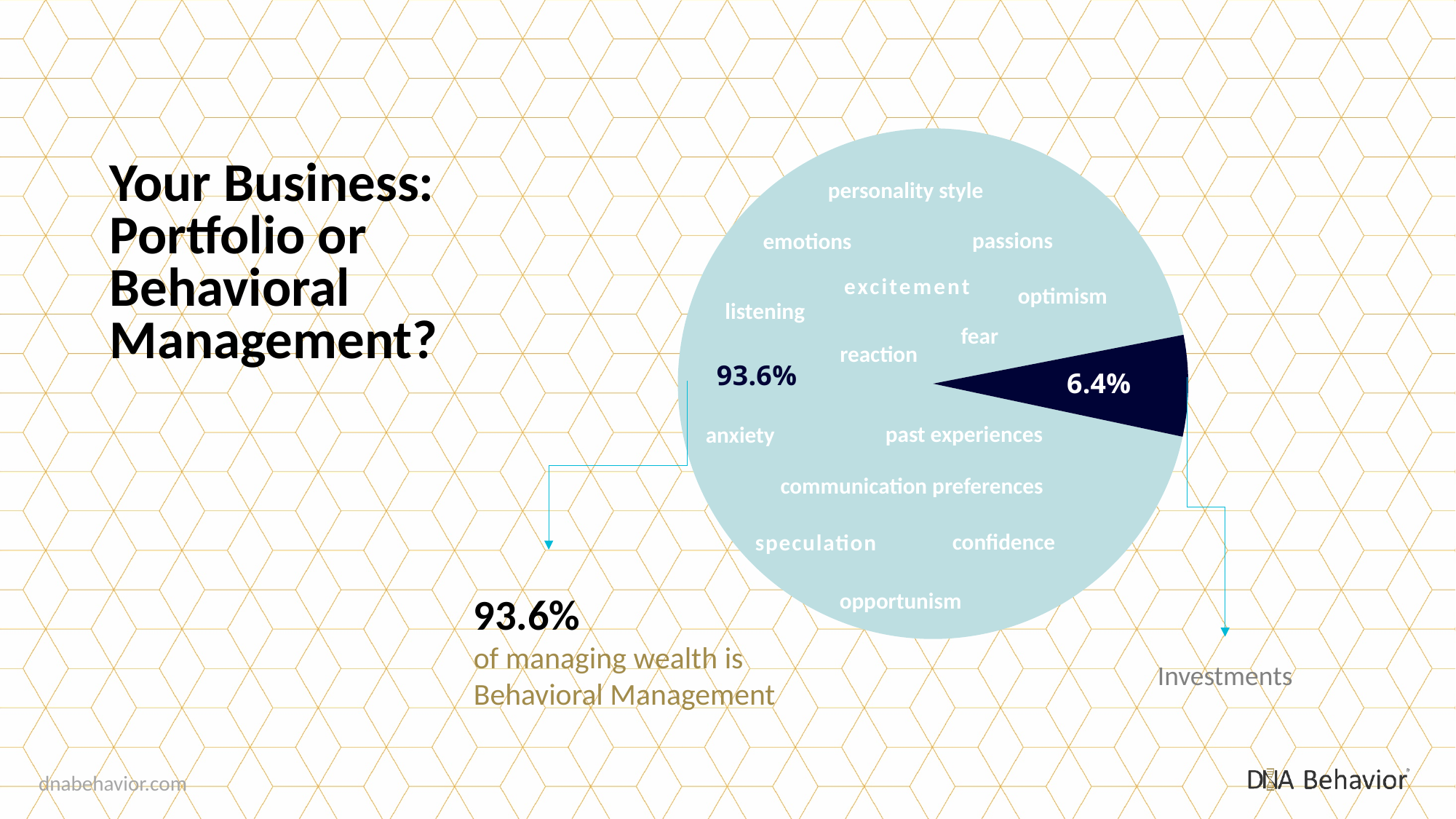
Which slice of the pie is the smallest? Investments What share of the pie is labelled Behavioral Management? 93.6% Which is larger, the Investments slice or the Behavioral Management slice? Behavioral Management What colour is the Investments slice of the pie? dark navy According to the slide, what percentage of managing wealth is Behavioral Management? 93.6% What kind of chart is shown on the slide? pie chart What is the total of the two pie slice percentages? 100% Which slice of the pie is the largest? Behavioral Management What is the difference in percentage points between the Behavioral Management slice and the Investments slice? 87.2 How many slices does the pie chart have? 2 What share of the pie is labelled Investments? 6.4%